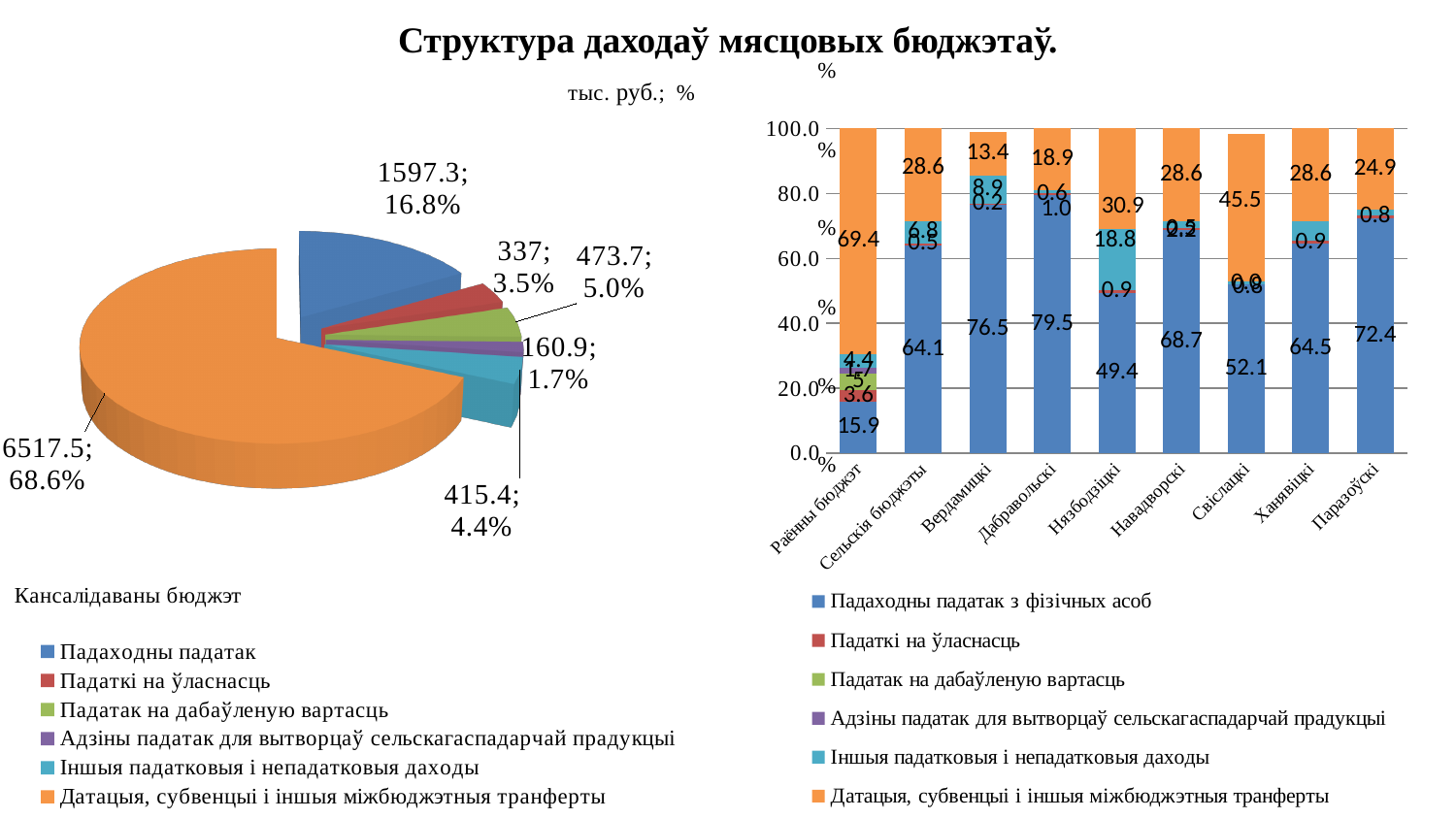
In the bar chart on the right, what is the difference between the Падаходны падатак з фізічных асоб values for Паразоўскі and Ханявіцкі? 7.9 How many categories are shown on the x axis of the bar chart on the right? 9 What type of chart is on the right side of the slide? Stacked bar chart In the bar chart on the right, which category has the lowest value for Падаходны падатак з фізічных асоб? Раённы бюджэт In the pie chart on the left, which category has the smallest slice? Адзіны падатак для вытворцаў сельскагаспадарчай прадукцыі How many categories does the legend of the pie chart on the left list? 6 In the bar chart on the right, what is the value of Датацыі, субвенцыі і іншыя міжбюджэтныя трансферты for Раённы бюджэт? 69.4 In the bar chart on the right, what is the value of Падаходны падатак з фізічных асоб for Дабравольскі? 79.5 In the pie chart on the left, what is the value labelled for Падаткі на ўласнасць? 337; 3.5% In the pie chart on the left, what share does Падаходны падатак have? 16.8% In the pie chart on the left, what value and share are shown for the largest slice (Датацыі, субвенцыі і іншыя міжбюджэтныя трансферты)? 6517.5; 68.6% In the bar chart on the right, which is larger: the Датацыі value for Свіслацкі or for Нязбодзіцкі? Свіслацкі